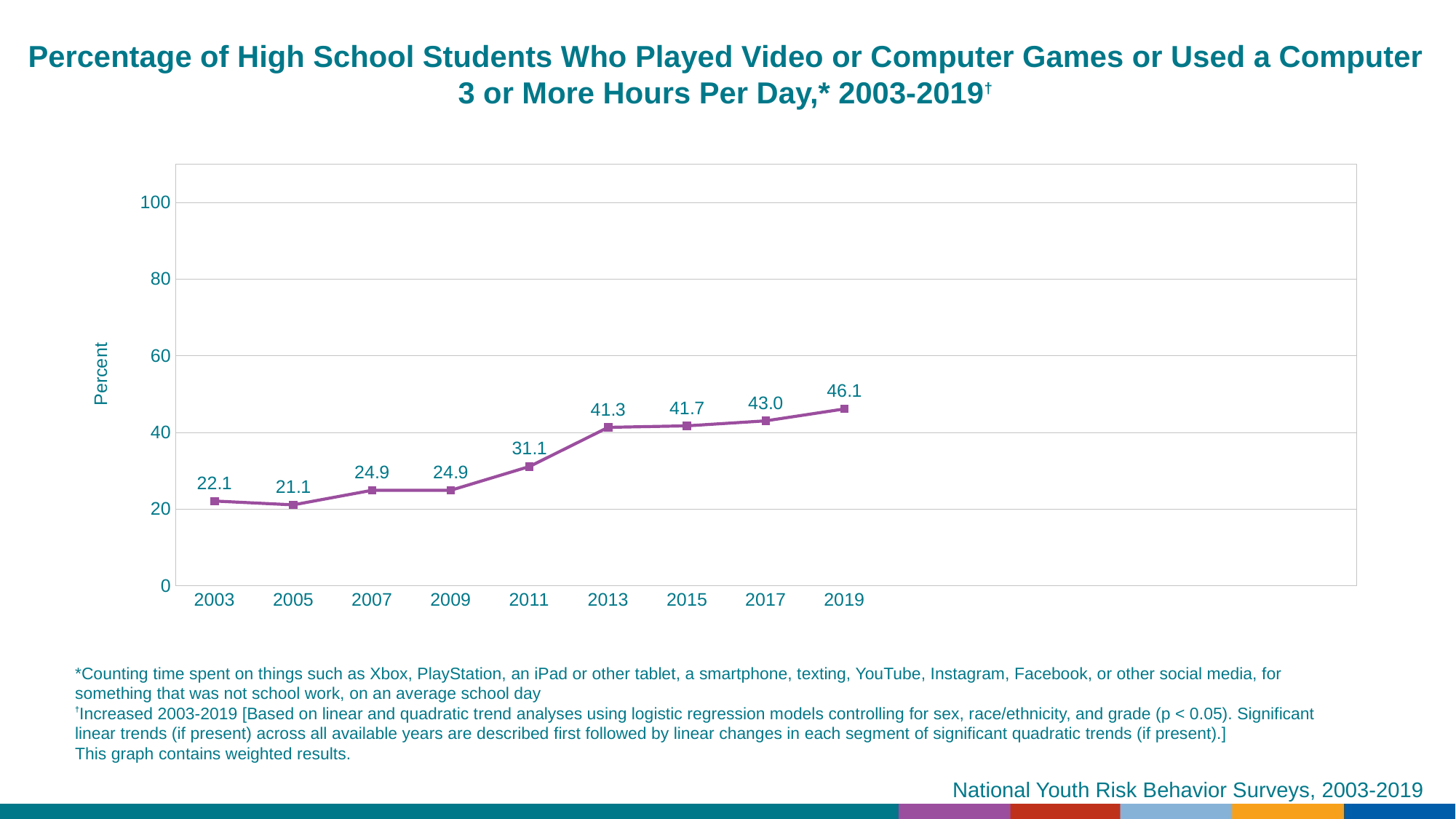
What value is shown for 2013? 41.3 What value is shown for 2019? 46.1 What was the percentage of high school students who played video or computer games or used a computer 3 or more hours per day in 2003? 22.1 Which year has the highest value on the chart? 2019 What kind of chart is shown on the slide? Line chart Which year has the larger value, 2011 or 2015? 2015 How many years are plotted on the chart? 9 Which year has the lowest value on the chart? 2005 Is the value for 2017 greater or less than 40? greater What is the difference between the values for 2013 and 2011? 10.2 What is the difference between the values for 2019 and 2003? 24.0 Do the values generally rise or fall from 2003 to 2019? Rise